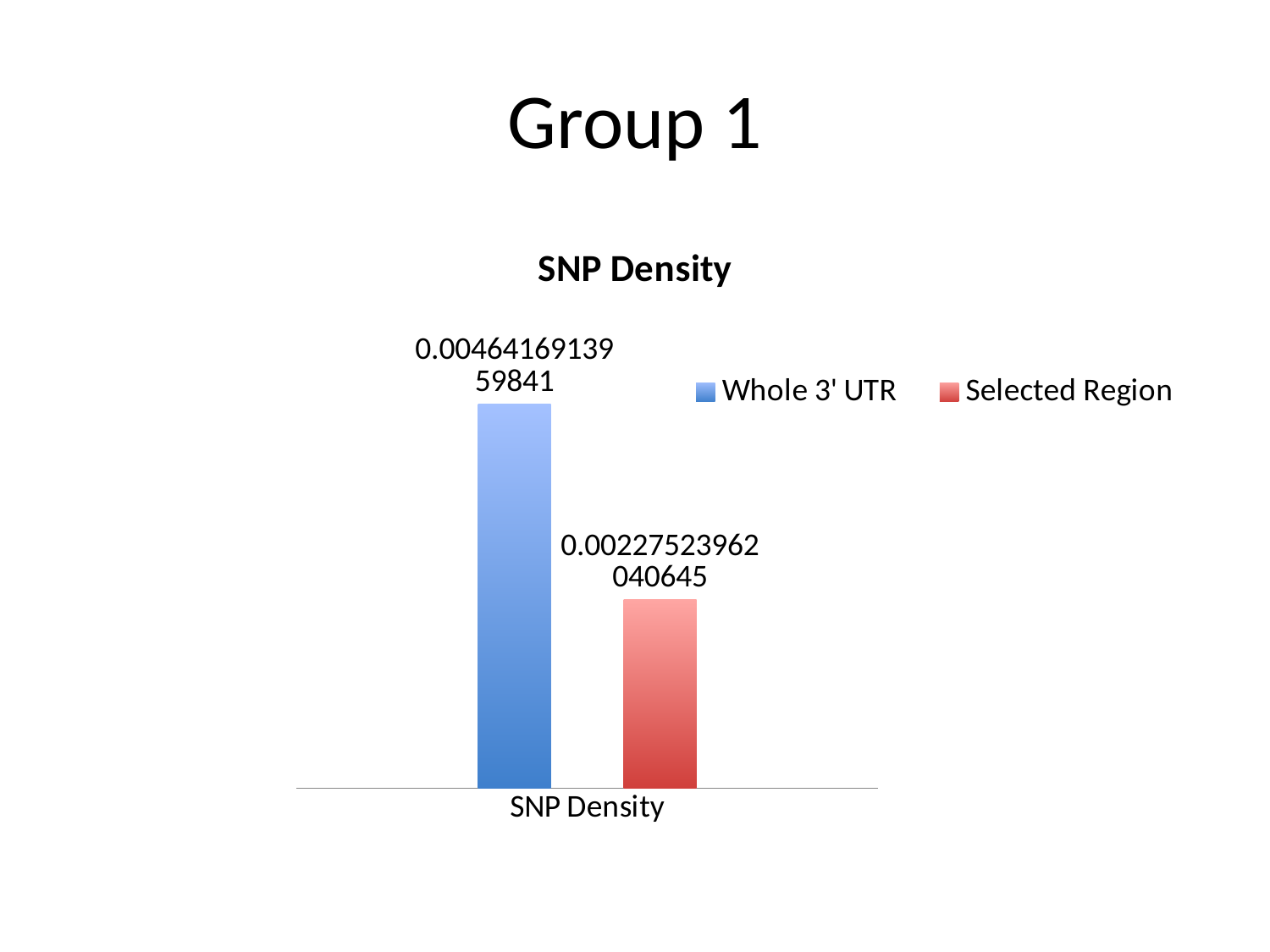
What is the title of the chart? SNP Density What is the difference between the Whole 3' UTR and Selected Region SNP density values? 0.00236645177557765 How many series does the legend list? 2 What colour is the bar for Selected Region? red Which series has the lower SNP density? Selected Region What kind of chart is shown on the slide? bar chart What is the SNP density value for Whole 3' UTR? 0.0046416913959841 Which series has the higher SNP density? Whole 3' UTR What is the SNP density value for Selected Region? 0.00227523962040645 How many categories are shown on the x axis? 1 Is the SNP density for Whole 3' UTR larger or smaller than that for Selected Region? larger